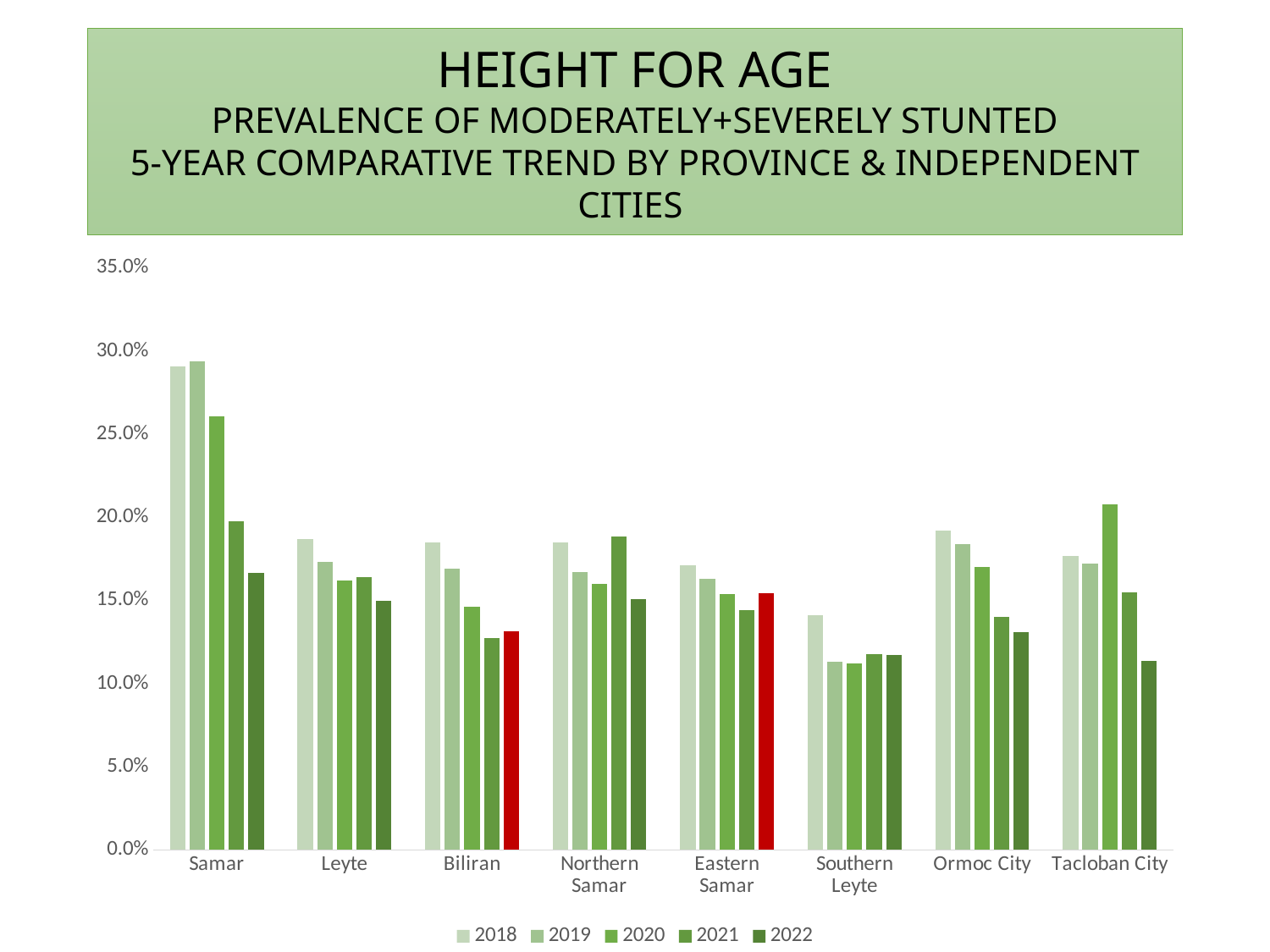
Which province or city has the lowest 2018 value? Southern Leyte Which bars on the chart are coloured red? The 2022 bars for Biliran and Eastern Samar How many provinces and cities are shown on the x axis? 8 How many series does the legend list? 5 Is the 2020 value for Southern Leyte greater or less than 15.0%? less Do the values for Samar rise or fall from 2019 to 2022? fall Which is larger, the 2018 value for Samar or the 2018 value for Leyte? Samar What kind of chart is shown on the slide? Bar chart Is the 2019 value for Samar greater or less than 25.0%? greater For Northern Samar, which is larger, the 2020 value or the 2021 value? 2021 Which province or city has the highest 2018 value? Samar For Tacloban City, which year has the highest value? 2020